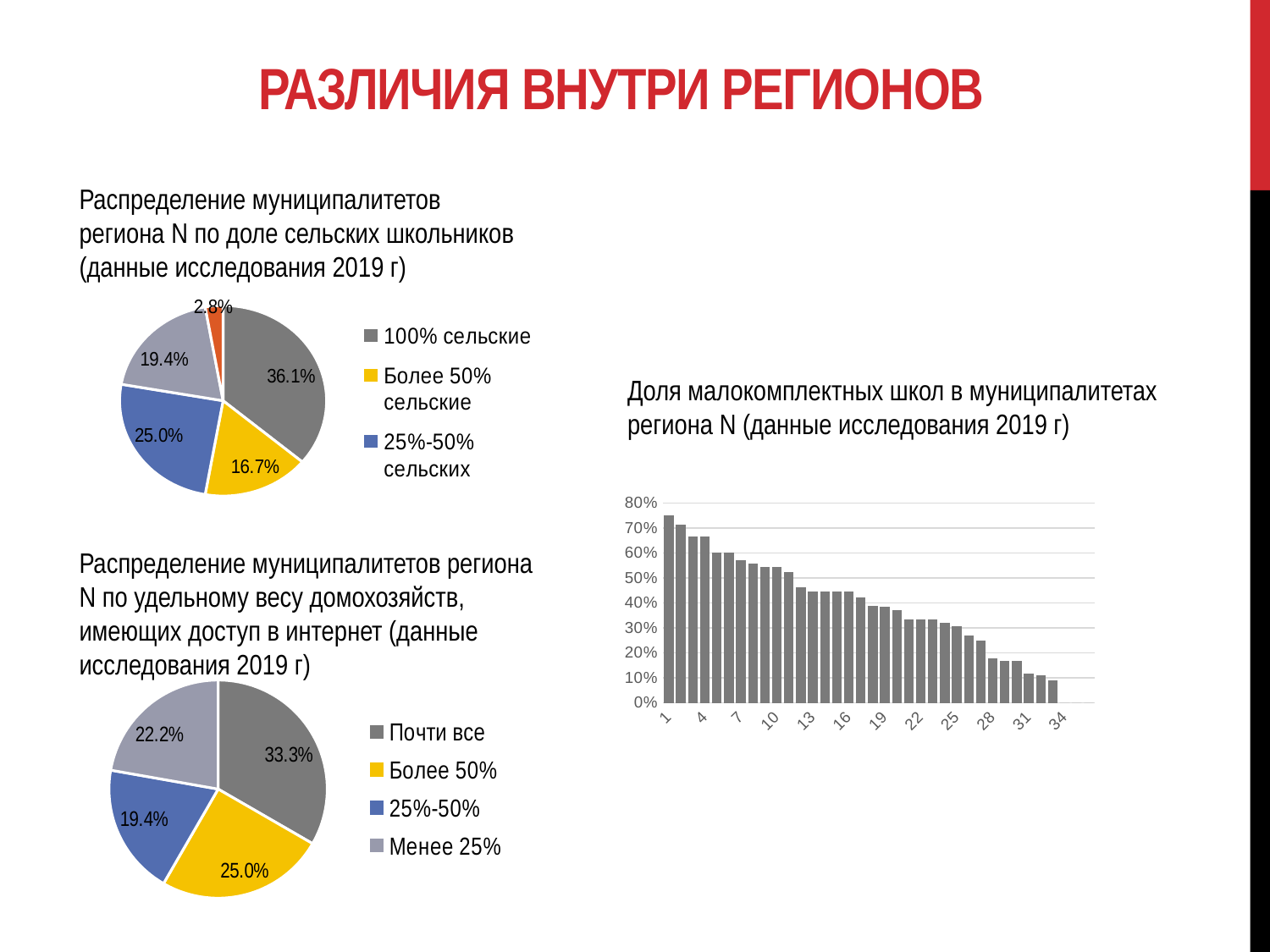
In the pie chart about the share of rural schoolchildren (top left), which legend category has the largest slice? 100% сельские In the bar chart on the right (Доля малокомплектных школ), is the value for municipality 1 greater or less than 70%? greater In the pie chart about households with internet access (bottom left), how many categories does the legend list? 4 In the pie chart about households with internet access (bottom left), which category has the smallest slice? 25%-50% In the pie chart about the share of rural schoolchildren (top left), what percentage is shown for '100% сельские'? 36.1% In the pie chart about the share of rural schoolchildren (top left), what percentage is shown for '25%-50% сельских'? 25.0% In the pie chart about households with internet access (bottom left), what percentage is shown for 'Менее 25%'? 22.2% What kind of chart is the chart on the right about the share of small schools (Доля малокомплектных школ)? Bar chart In the pie chart about households with internet access (bottom left), what percentage is shown for 'Почти все'? 33.3% In the pie chart about the share of rural schoolchildren (top left), what is the difference between the '100% сельские' slice and the 'Более 50% сельские' slice? 19.4% In the bar chart on the right (Доля малокомплектных школ), do the values rise or fall from left to right along the x axis? Fall In the pie chart about households with internet access (bottom left), which is larger: 'Более 50%' or 'Менее 25%'? Более 50%